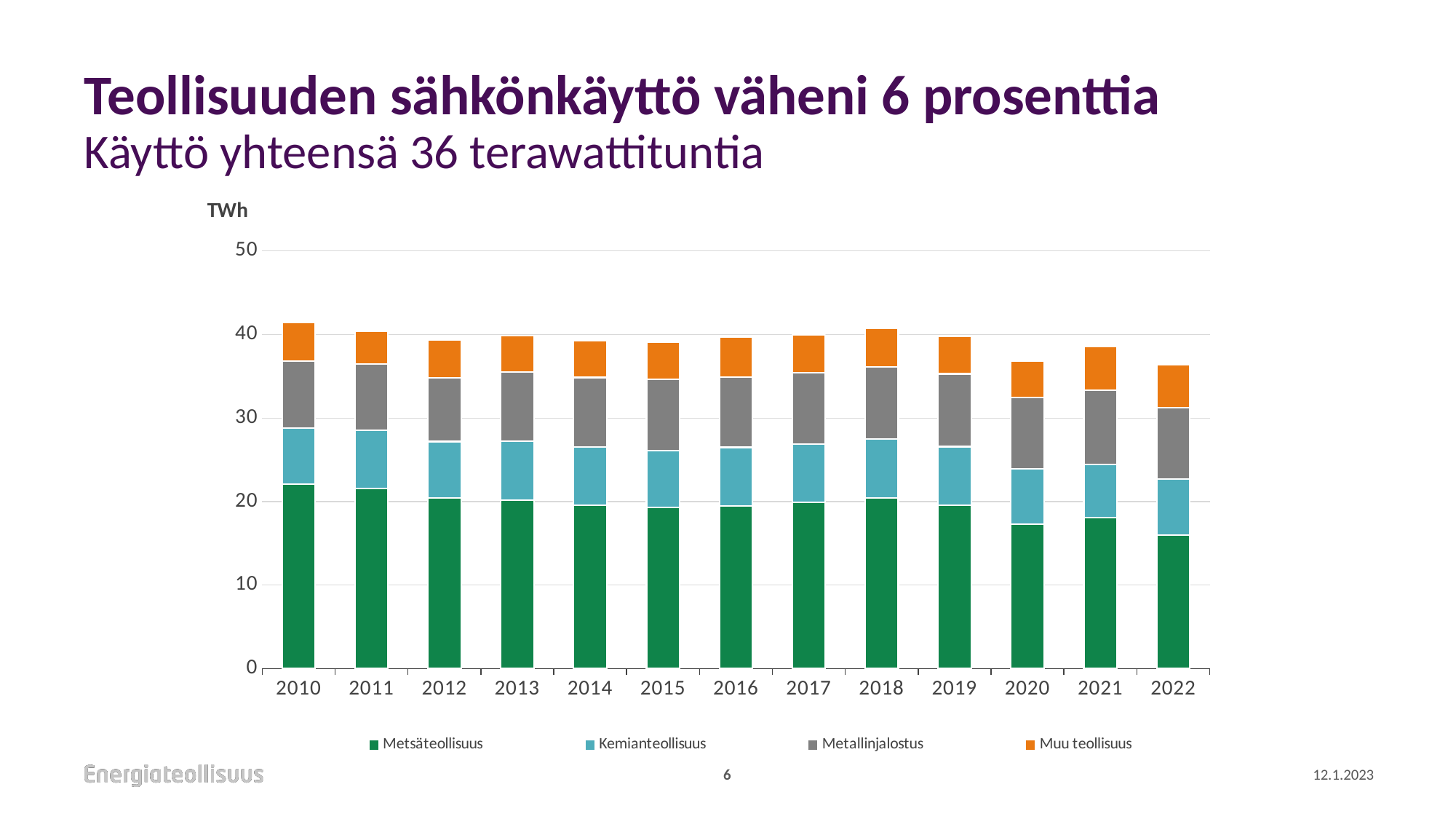
Which year has the larger total stacked value, 2020 or 2021? 2021 How many years are shown on the x axis of the chart? 13 How many series does the chart's legend list? 4 Is the total stacked value for 2010 greater or less than 40? greater Is the total stacked value for 2022 greater or less than 40? less Is the Metsäteollisuus value for 2010 greater or less than 20? greater Which is larger, the Metsäteollisuus value for 2010 or for 2022? 2010 Does the Metsäteollisuus series rise or fall overall from 2010 to 2022? fall What unit is shown above the y axis of the chart? TWh What kind of chart is shown on the slide? bar chart